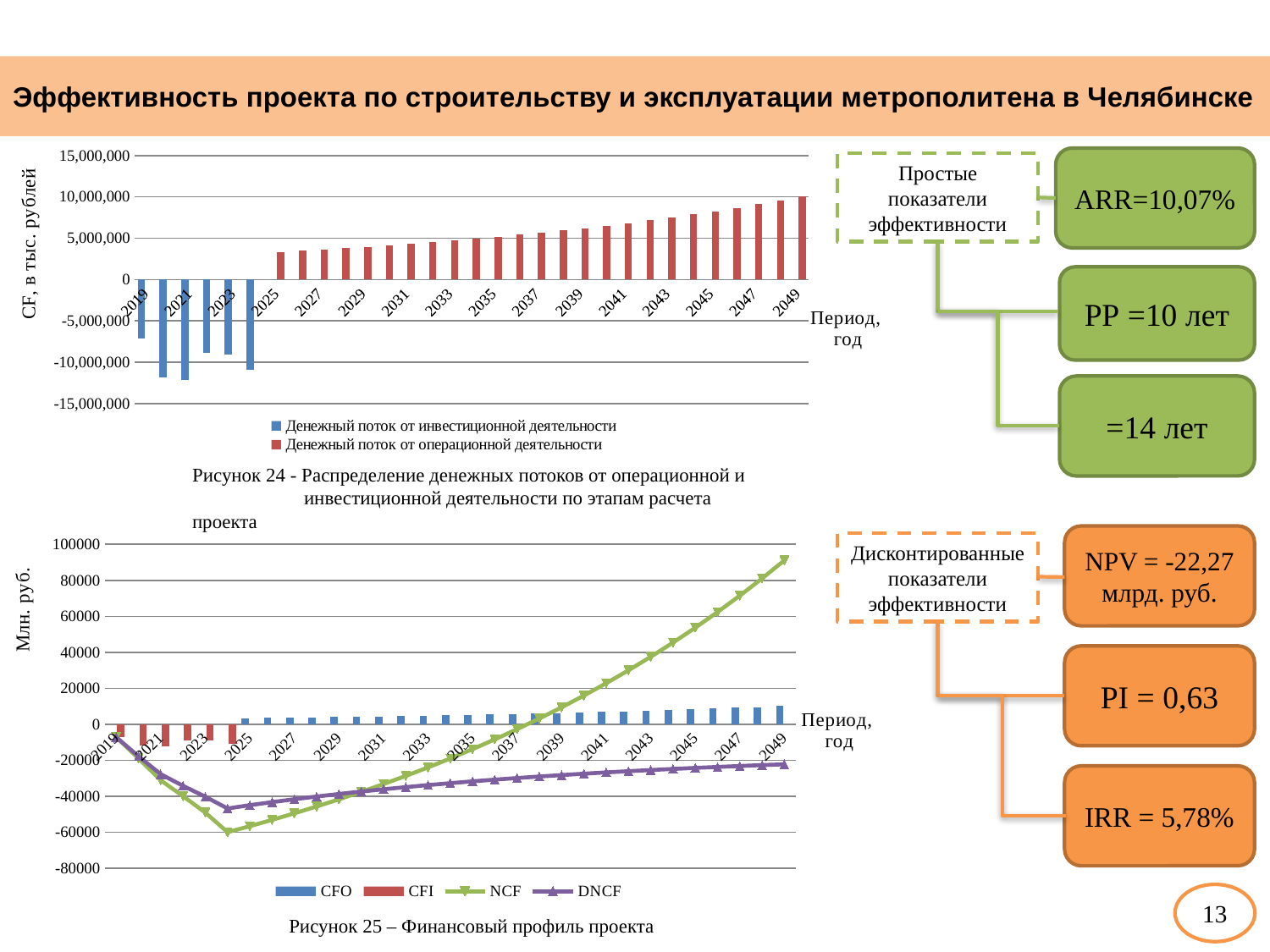
In the top chart (Рисунок 24), which year has the highest operating cash flow (Денежный поток от операционной деятельности)? 2049 In the top chart (Рисунок 24), is the investment cash flow for 2021 greater or less than -10,000,000? less What is the y-axis label of the top chart (Рисунок 24)? CF, в тыс. рублей In the top chart (Рисунок 24), which is larger: the operating cash flow in 2027 or in 2047? 2047 In the top chart (Рисунок 24), how many series does the legend list? 2 In the top chart (Рисунок 24), is the operating cash flow for 2049 greater or less than 5,000,000? greater In the bottom chart (Рисунок 25), which is larger in 2049: NCF or DNCF? NCF In the bottom chart (Рисунок 25), how many series does the legend list? 4 What kind of chart is the top chart (Рисунок 24)? bar chart In the top chart (Рисунок 24), do the operating cash flow bars rise or fall from 2025 to 2049? rise In the bottom chart (Рисунок 25), is the NCF value for 2049 greater or less than 80000? greater In the bottom chart (Рисунок 25), in which year does the NCF line reach its lowest value? 2024